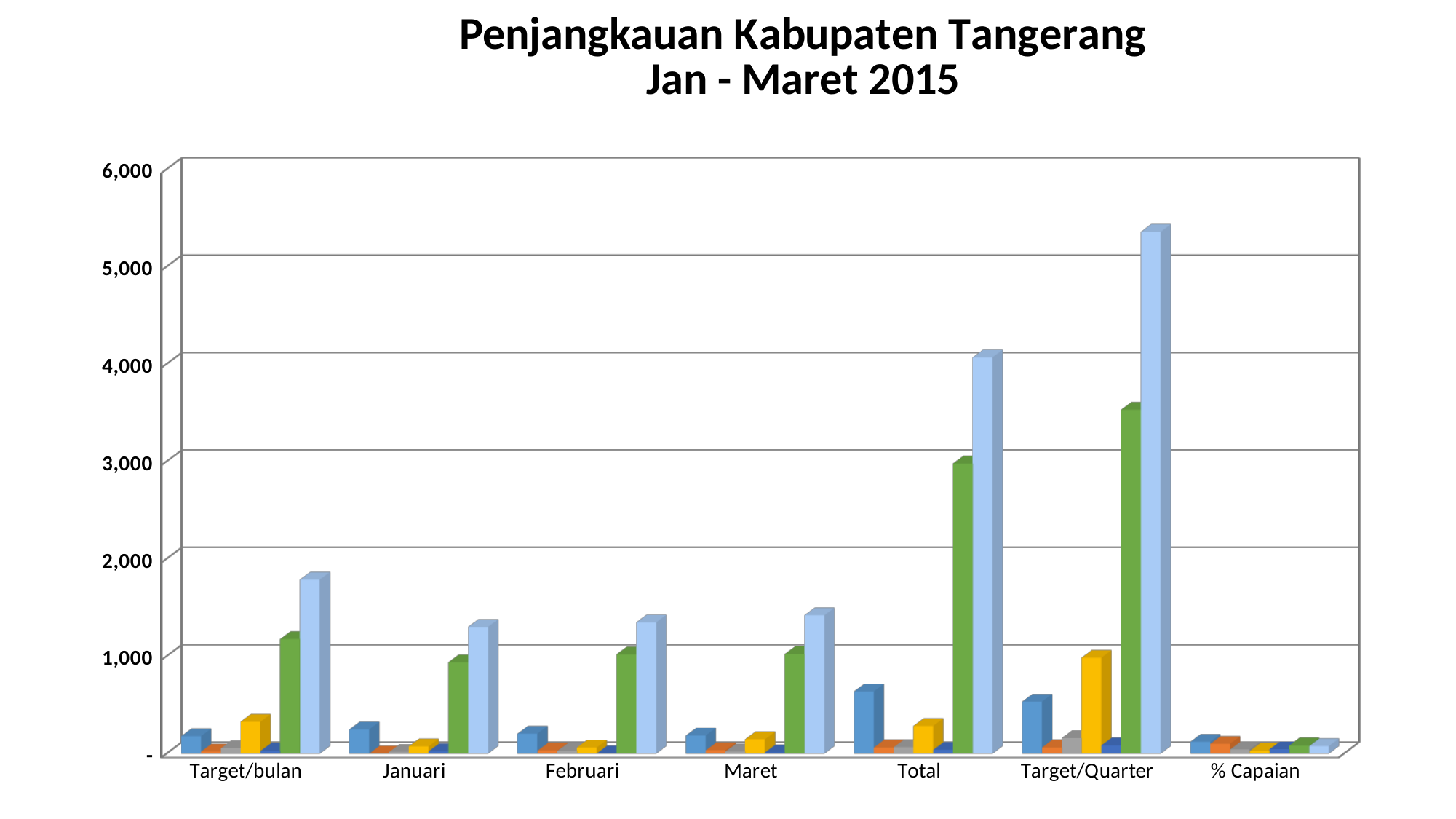
Which is larger, the light blue bar for Total or the light blue bar for Target/Quarter? Target/Quarter Is the green bar for Target/Quarter greater or less than 3,000? greater Which category has the tallest light blue bar? Target/Quarter What kind of chart is shown on the slide? Bar chart Is the light blue bar for Total greater or less than 3,000? greater What is the highest value shown on the vertical axis? 6,000 Which category has the tallest green bar? Target/Quarter Is the light blue bar for Target/bulan greater or less than 2,000? less What is the title of the chart? Penjangkauan Kabupaten Tangerang Jan - Maret 2015 How many categories are shown on the x axis of the chart? 7